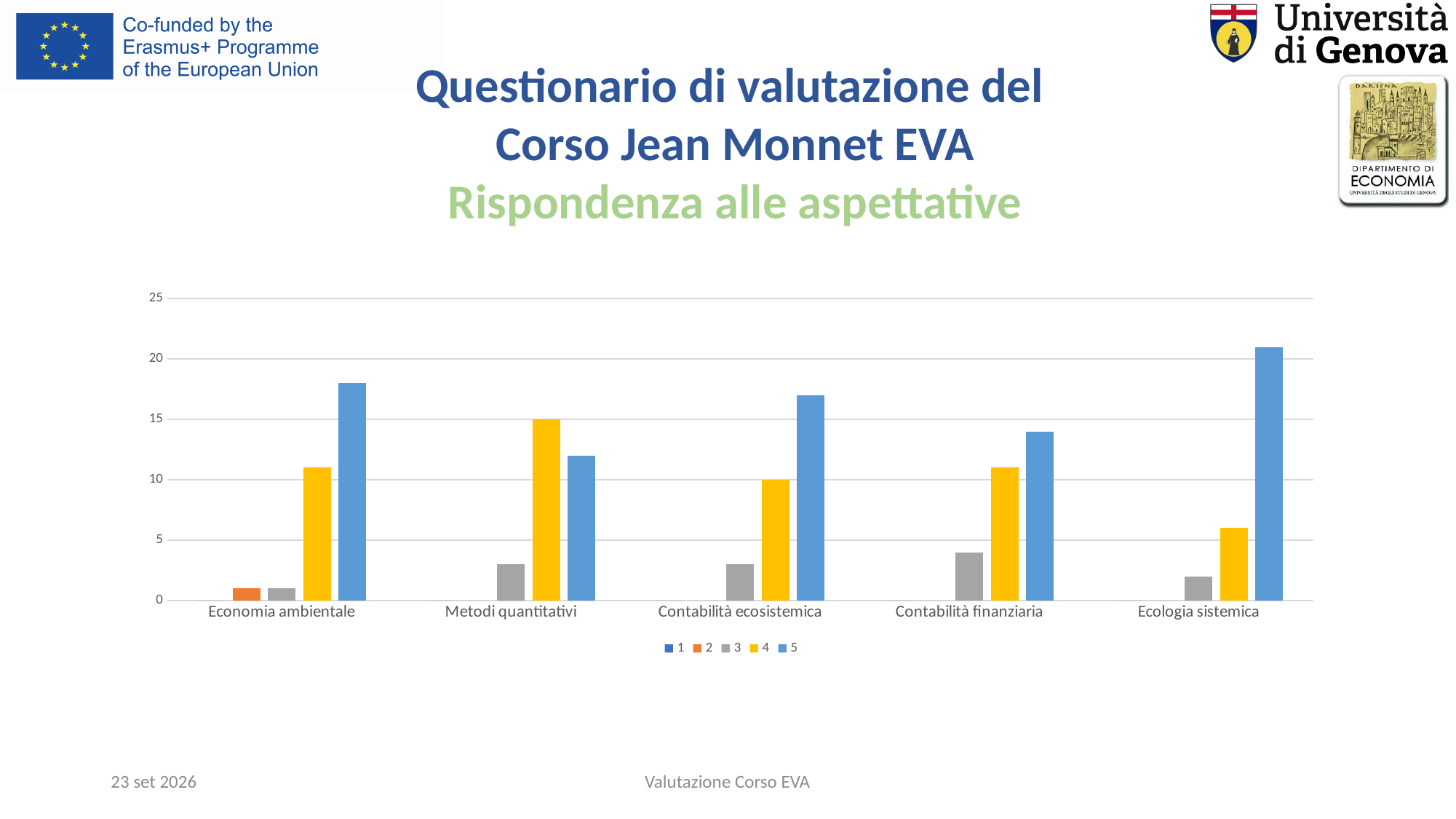
Is the value for series 4 in Ecologia sistemica greater or less than 10? less Which category has the highest value for series 5? Ecologia sistemica How many categories are shown on the x axis of the chart? 5 Is the value for series 5 in Economia ambientale greater or less than 15? greater How many series does the chart's legend list? 5 What kind of chart is shown on the slide? bar chart What is the green subtitle shown above the chart? Rispondenza alle aspettative Which category has the lowest value for series 5? Metodi quantitativi In Metodi quantitativi, which is larger: the value for series 4 or the value for series 5? series 4 Is the value for series 5 in Ecologia sistemica greater or less than 20? greater In Contabilità ecosistemica, which is larger: the value for series 3 or the value for series 4? series 4